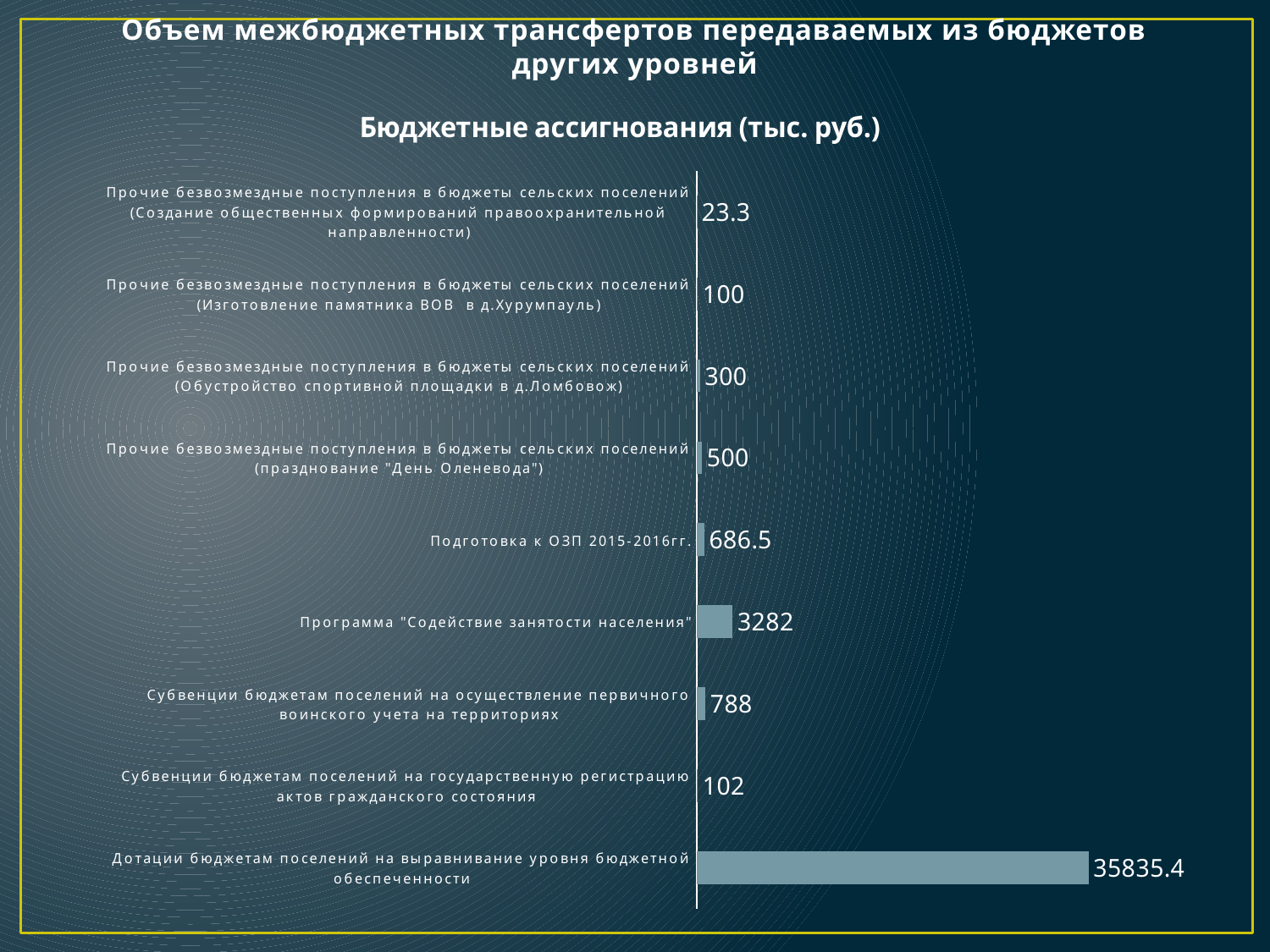
What is the value for "Подготовка к ОЗП 2015-2016гг."? 686.5 What is the difference between the value for "Программа "Содействие занятости населения"" and the value for "Субвенции бюджетам поселений на осуществление первичного воинского учета на территориях"? 2494 Which category has the highest value? Дотации бюджетам поселений на выравнивание уровня бюджетной обеспеченности What is the difference between the value for "Прочие безвозмездные поступления в бюджеты сельских поселений (празднование "День Оленевода")" and the value for "Прочие безвозмездные поступления в бюджеты сельских поселений (Обустройство спортивной площадки в д.Ломбовож)"? 200 What is the title of the chart? Бюджетные ассигнования (тыс. руб.) Which is larger: the value for "Субвенции бюджетам поселений на осуществление первичного воинского учета на территориях" or the value for "Подготовка к ОЗП 2015-2016гг."? Субвенции бюджетам поселений на осуществление первичного воинского учета на территориях How many categories are shown in the chart? 9 What is the value for "Субвенции бюджетам поселений на государственную регистрацию актов гражданского состояния"? 102 What is the value for "Дотации бюджетам поселений на выравнивание уровня бюджетной обеспеченности"? 35835.4 What kind of chart is shown on the slide? Bar chart Which category has the lowest value? Прочие безвозмездные поступления в бюджеты сельских поселений (Создание общественных формирований правоохранительной направленности) What is the value for "Программа "Содействие занятости населения""? 3282